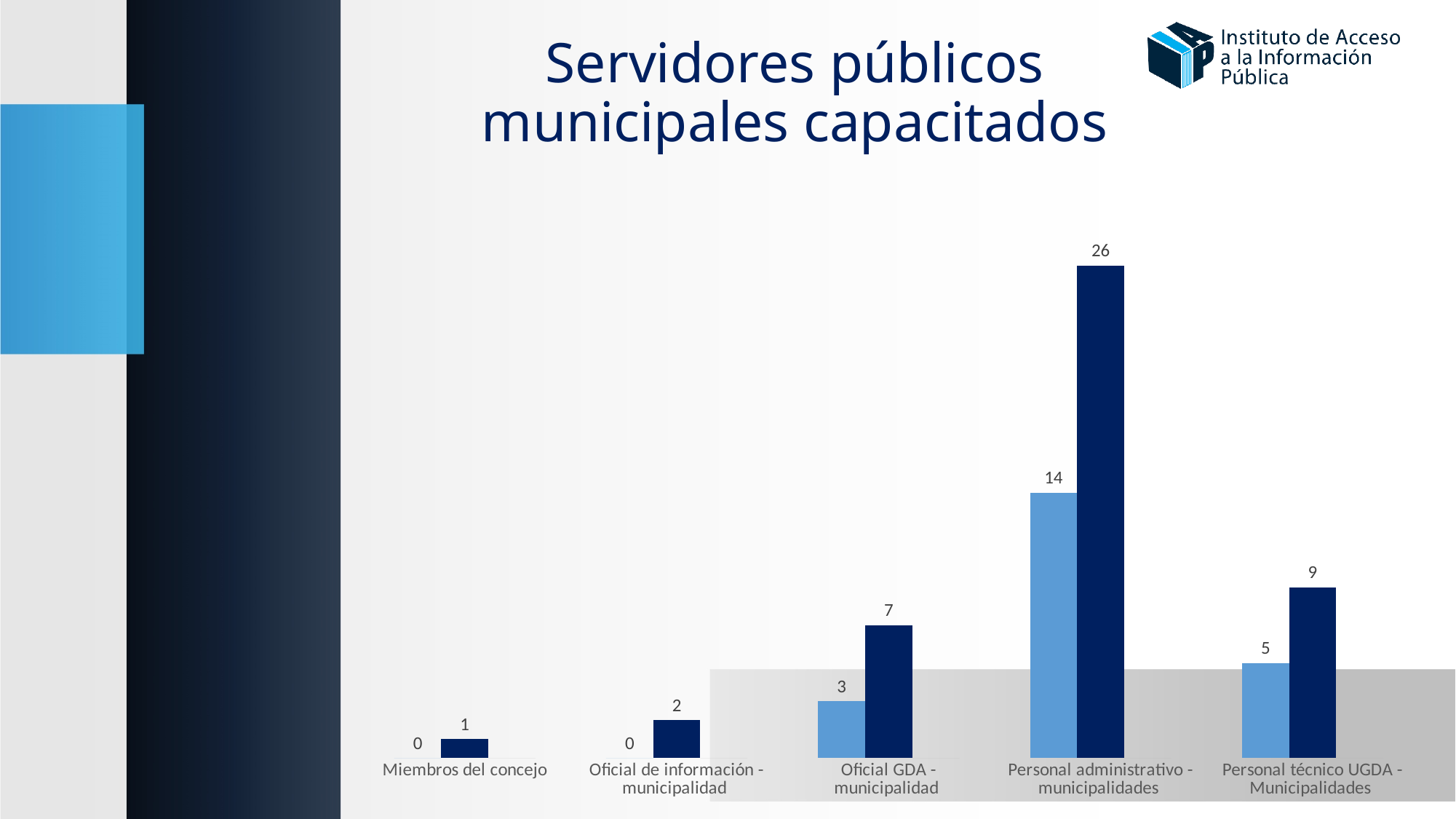
What is the difference between the dark blue bars for Personal técnico UGDA - Municipalidades and Oficial GDA - municipalidad? 2 What type of chart is shown on the slide? Bar chart What is the difference between the dark blue and light blue bars for Personal administrativo - municipalidades? 12 Which category has the highest dark blue bar? Personal administrativo - municipalidades How many categories are shown on the x axis? 5 Which category has the lowest dark blue bar? Miembros del concejo What is the value of the light blue bar for Personal administrativo - municipalidades? 14 What is the value of the dark blue bar for Oficial GDA - municipalidad? 7 Which is larger: the dark blue bar for Personal técnico UGDA - Municipalidades or the dark blue bar for Oficial GDA - municipalidad? Personal técnico UGDA - Municipalidades What is the value of the dark blue bar for Personal administrativo - municipalidades? 26 What is the value of the light blue bar for Personal técnico UGDA - Municipalidades? 5 What is the value of the light blue bar for Miembros del concejo? 0